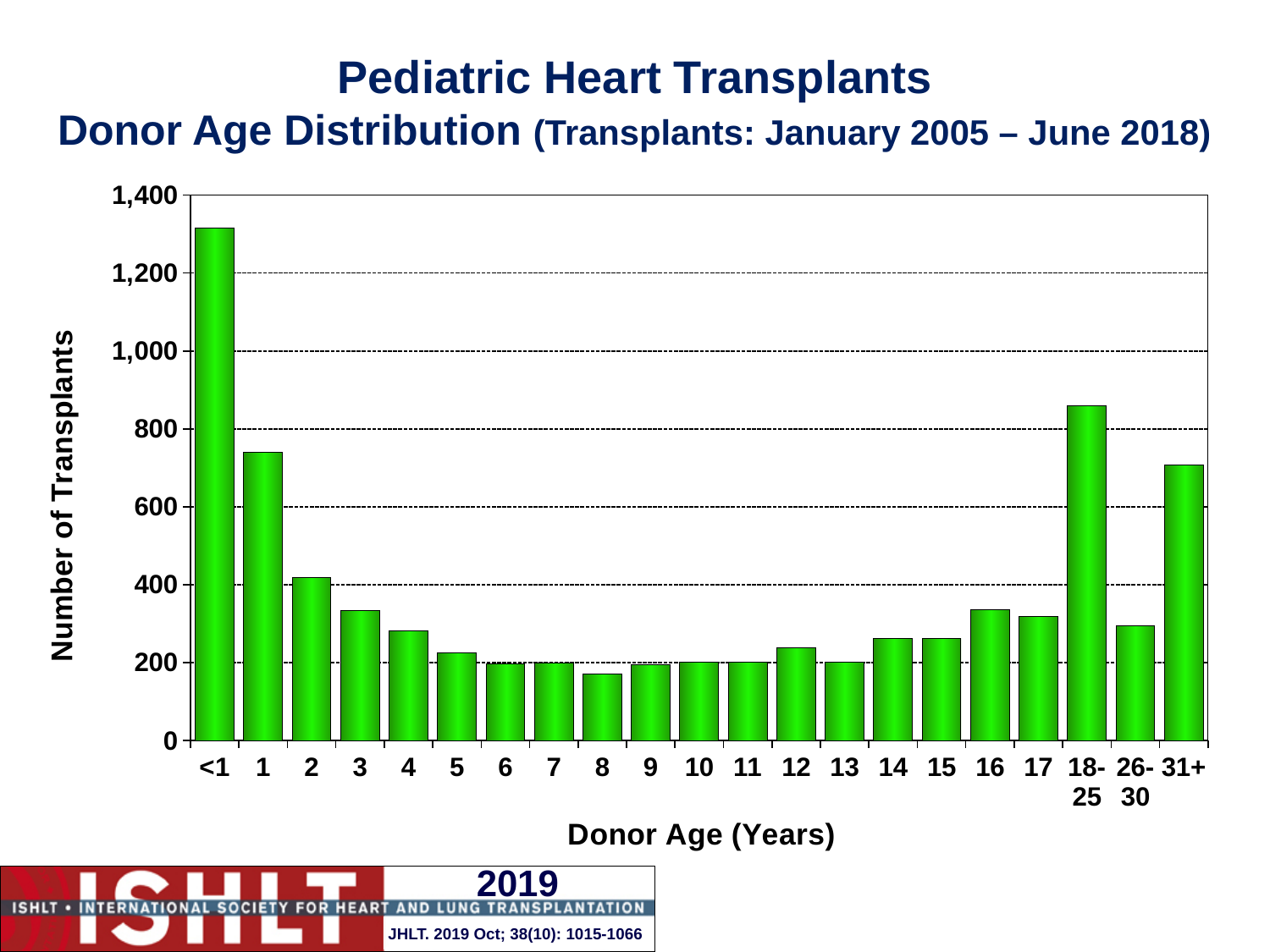
Is the number of transplants for donor age 18-25 greater or less than 800? greater Which has more transplants, donor age 18-25 or donor age 31+? 18-25 Is the number of transplants for donor age 31+ greater or less than 800? less Which donor age category has the lowest number of transplants? 8 What kind of chart is shown on the slide? bar chart Which donor age category has the highest number of transplants? <1 Is the number of transplants for donor age <1 greater or less than 1,200? greater Do the number of transplants rise or fall as donor age goes from <1 to 8? fall What is the label of the y axis? Number of Transplants How many donor age categories are shown on the x axis? 21